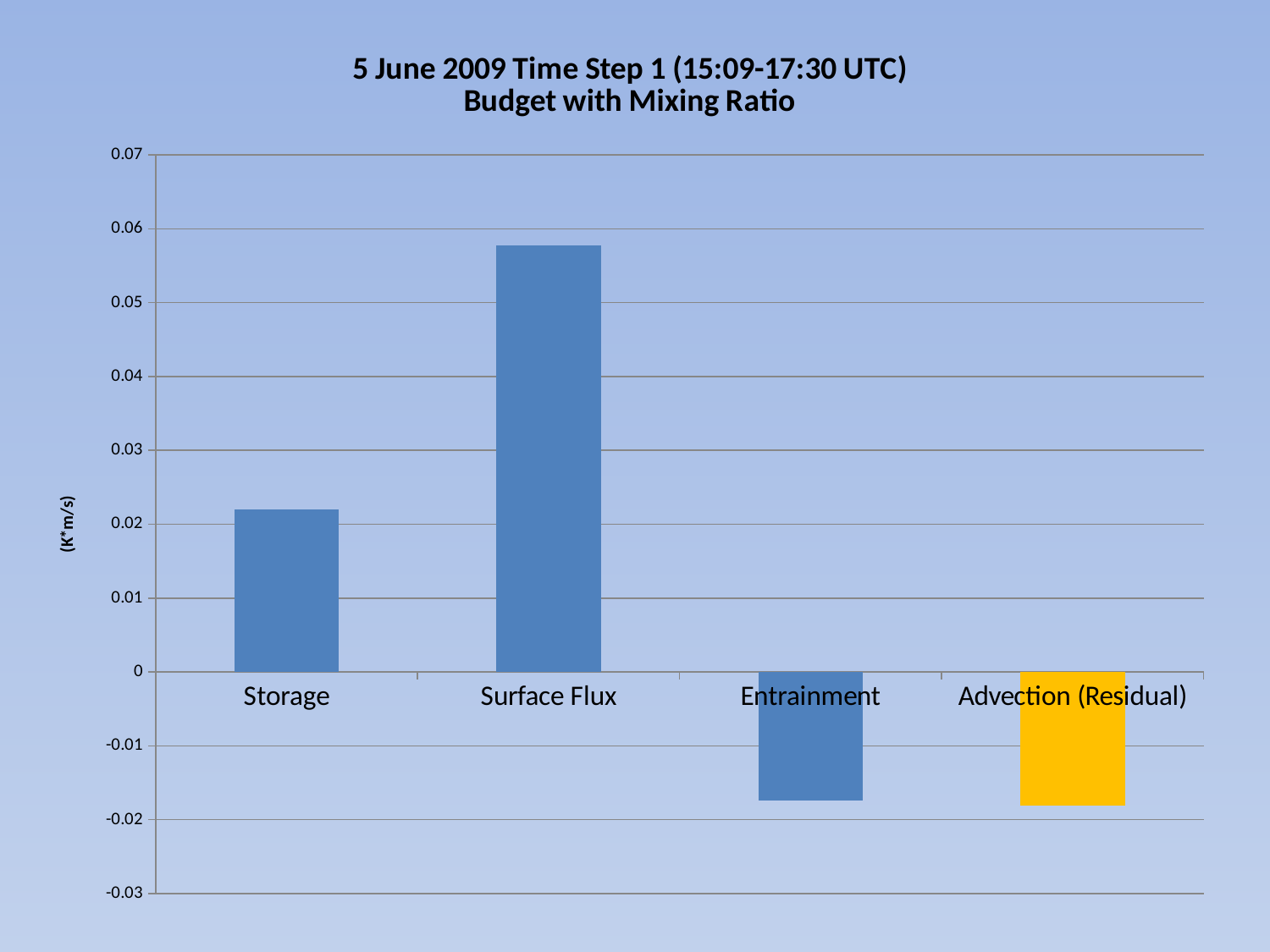
What unit label is shown on the vertical axis? (K*m/s) Is the value for Storage greater or less than 0.03? less What kind of chart is shown on the slide? bar chart Which is larger, the value for Storage or the value for Entrainment? Storage Is the value for Advection (Residual) greater or less than 0? less Is the value for Entrainment greater or less than -0.01? less What is the title of the chart? 5 June 2009 Time Step 1 (15:09-17:30 UTC) Budget with Mixing Ratio How many categories are plotted on the chart? 4 Which is larger, the value for Storage or the value for Surface Flux? Surface Flux Which category has the highest value? Surface Flux